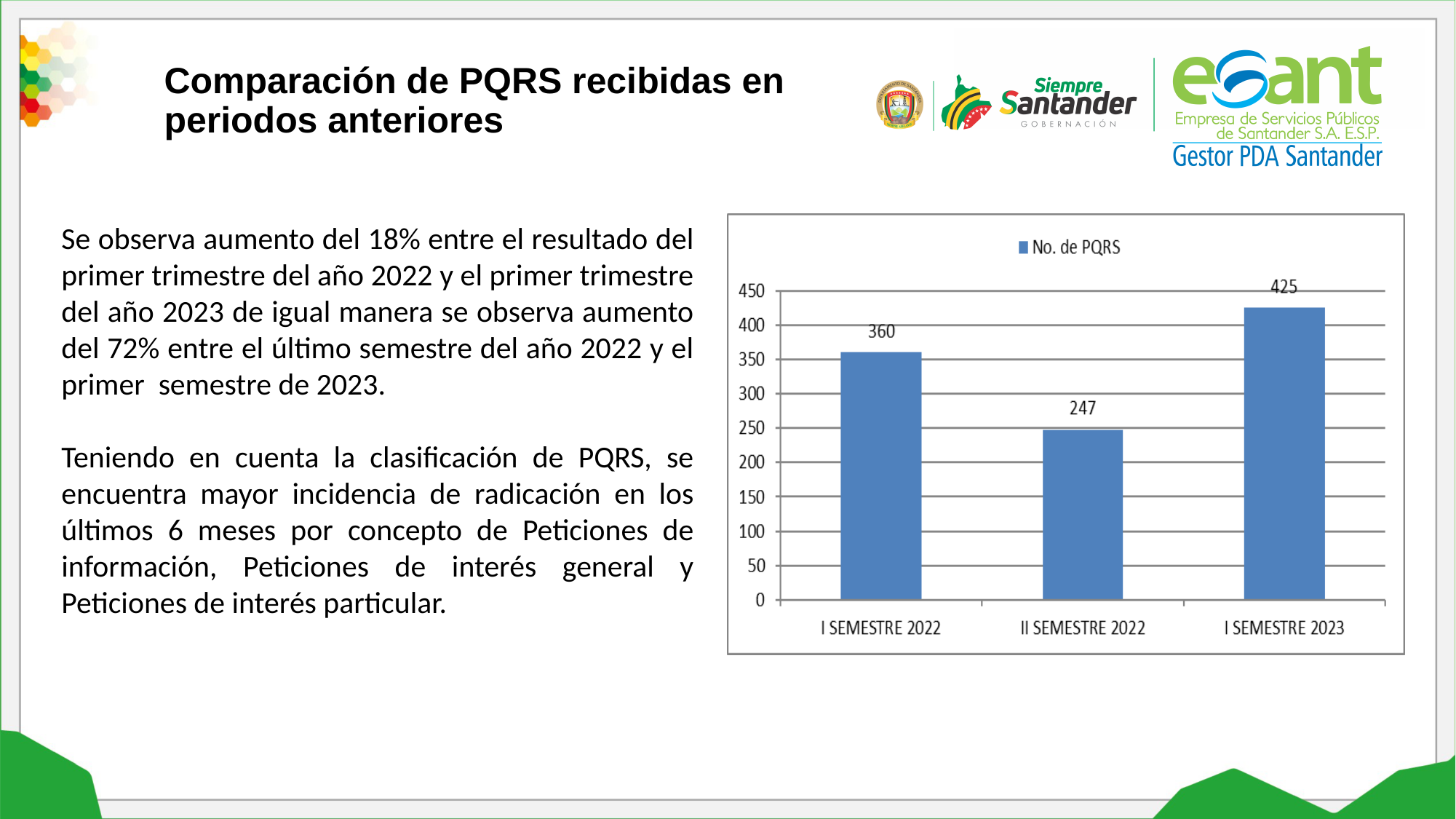
Which category has the highest value? I SEMESTRE 2023 What is the value for I SEMESTRE 2022? 360 Is the value for II SEMESTRE 2022 greater or less than 300? less Which category has the lowest value? II SEMESTRE 2022 Which is larger, the value for I SEMESTRE 2022 or the value for I SEMESTRE 2023? I SEMESTRE 2023 What is the difference between the values for I SEMESTRE 2022 and II SEMESTRE 2022? 113 What is the value for II SEMESTRE 2022? 247 What series name does the legend show? No. de PQRS What is the value for I SEMESTRE 2023? 425 What kind of chart is shown on the slide? bar chart How many categories are shown on the x axis? 3 What is the difference between the values for I SEMESTRE 2023 and II SEMESTRE 2022? 178